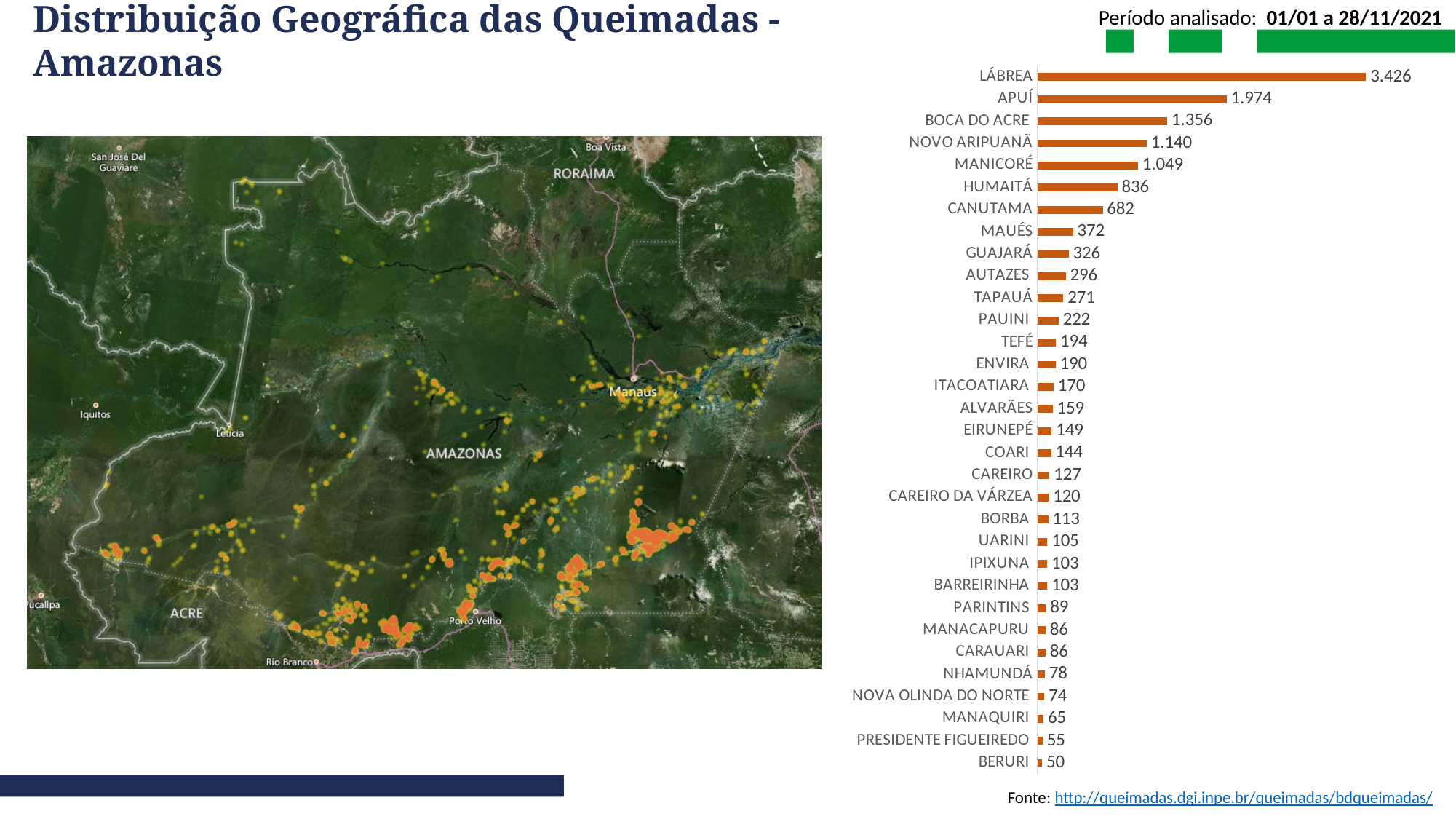
Which has a larger value, PARINTINS or NHAMUNDÁ? PARINTINS What kind of chart is shown on the right side of the slide? Bar chart Which has a larger value, BOCA DO ACRE or MANICORÉ? BOCA DO ACRE What is the difference between the values for CANUTAMA and MAUÉS? 310 What is the difference between the values for LÁBREA and APUÍ? 1.452 Which municipality has the lowest value in the bar chart? BERURI Which municipality has the highest value in the bar chart? LÁBREA How many municipalities are shown in the bar chart? 32 What is the value for HUMAITÁ in the bar chart? 836 What period is analysed according to the text above the chart? 01/01 a 28/11/2021 What is the value for LÁBREA in the bar chart? 3.426 What is the value for TEFÉ in the bar chart? 194